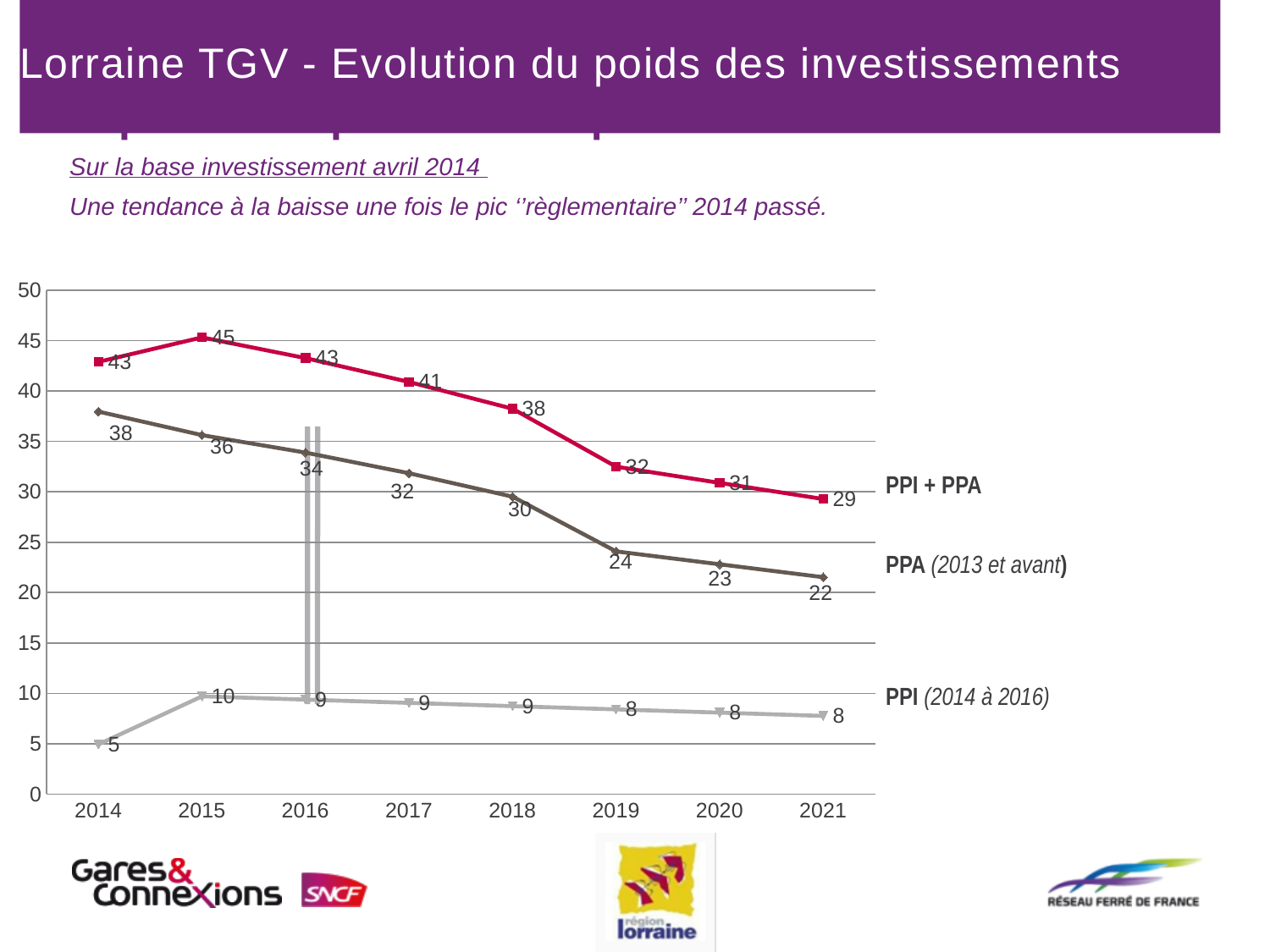
In which year is the PPA (2013 et avant) series at its lowest value? 2021 What is the value of the PPA (2013 et avant) series in 2019? 24 How many series are plotted on the chart? 3 How many years are shown on the x axis? 8 Does the PPA (2013 et avant) series rise or fall from 2014 to 2021? Fall What is the difference between the PPI + PPA value in 2014 and in 2021? 14 What is the value of the PPI (2014 à 2016) series in 2014? 5 What type of chart is shown on the slide? Line chart Which is larger in 2018: the PPA (2013 et avant) value or the PPI (2014 à 2016) value? PPA (2013 et avant) What is the value of the PPI + PPA series in 2015? 45 In which year does the PPI + PPA series reach its highest value? 2015 What is the difference between the PPI + PPA value and the PPA (2013 et avant) value in 2020? 8